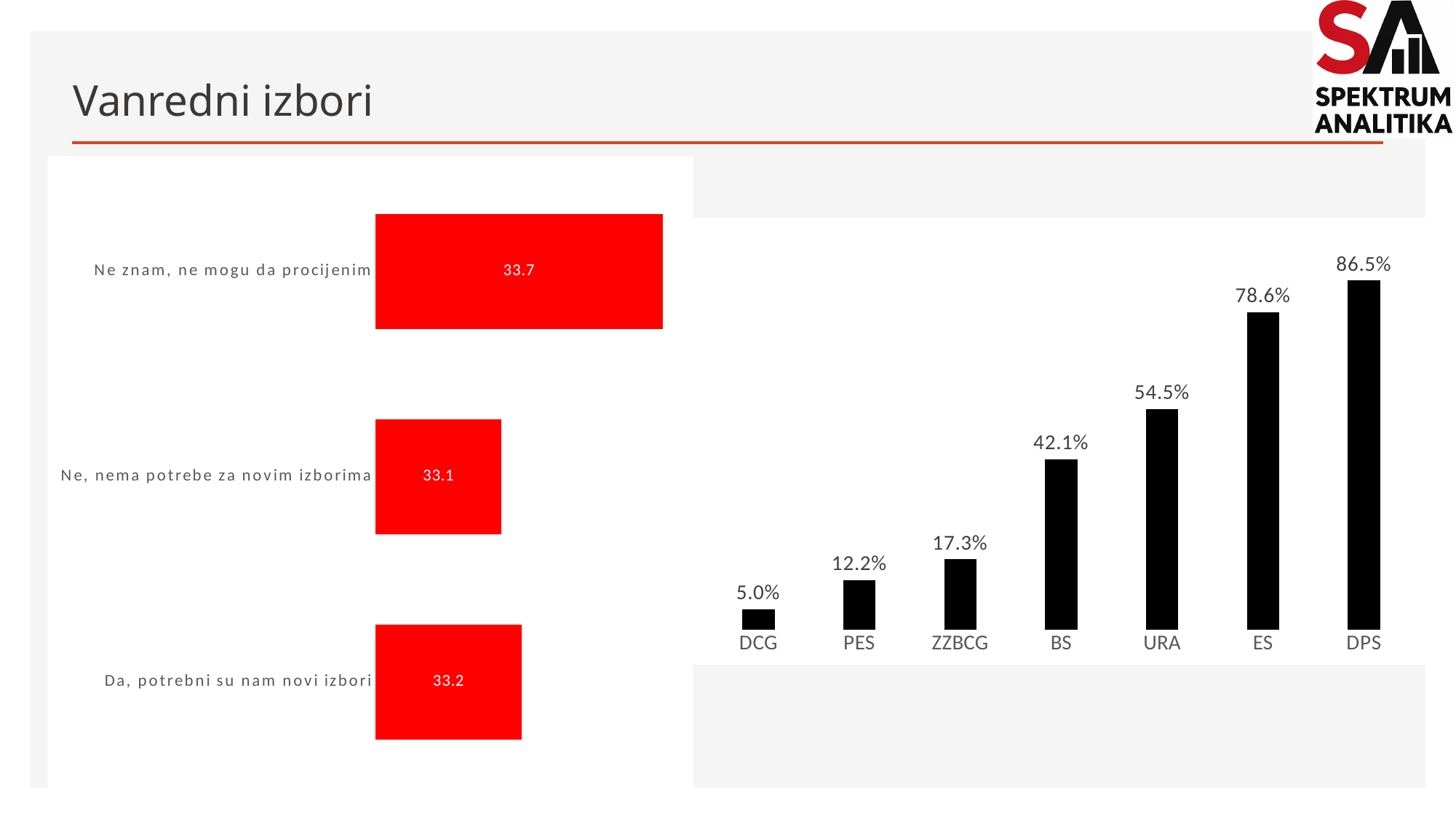
In the right chart, what is the value for URA? 54.5% In the right chart, which category has the highest value? DPS In the right chart, do the values rise or fall from left to right along the x axis? rise In the left chart, which category has the lowest value? Ne, nema potrebe za novim izborima In the right chart, which category has the lowest value? DCG In the left chart, what is the value for "Da, potrebni su nam novi izbori"? 33.2 In the right chart, how many categories are shown? 7 In the left chart, how many categories are shown? 3 In the left chart, what is the value for "Ne znam, ne mogu da procijenim"? 33.7 In the left chart, what is the difference between the values for "Ne znam, ne mogu da procijenim" and "Ne, nema potrebe za novim izborima"? 0.6 In the right chart, what is the value for ZZBCG? 17.3% In the right chart, what is the difference between the values for DPS and ES? 7.9%